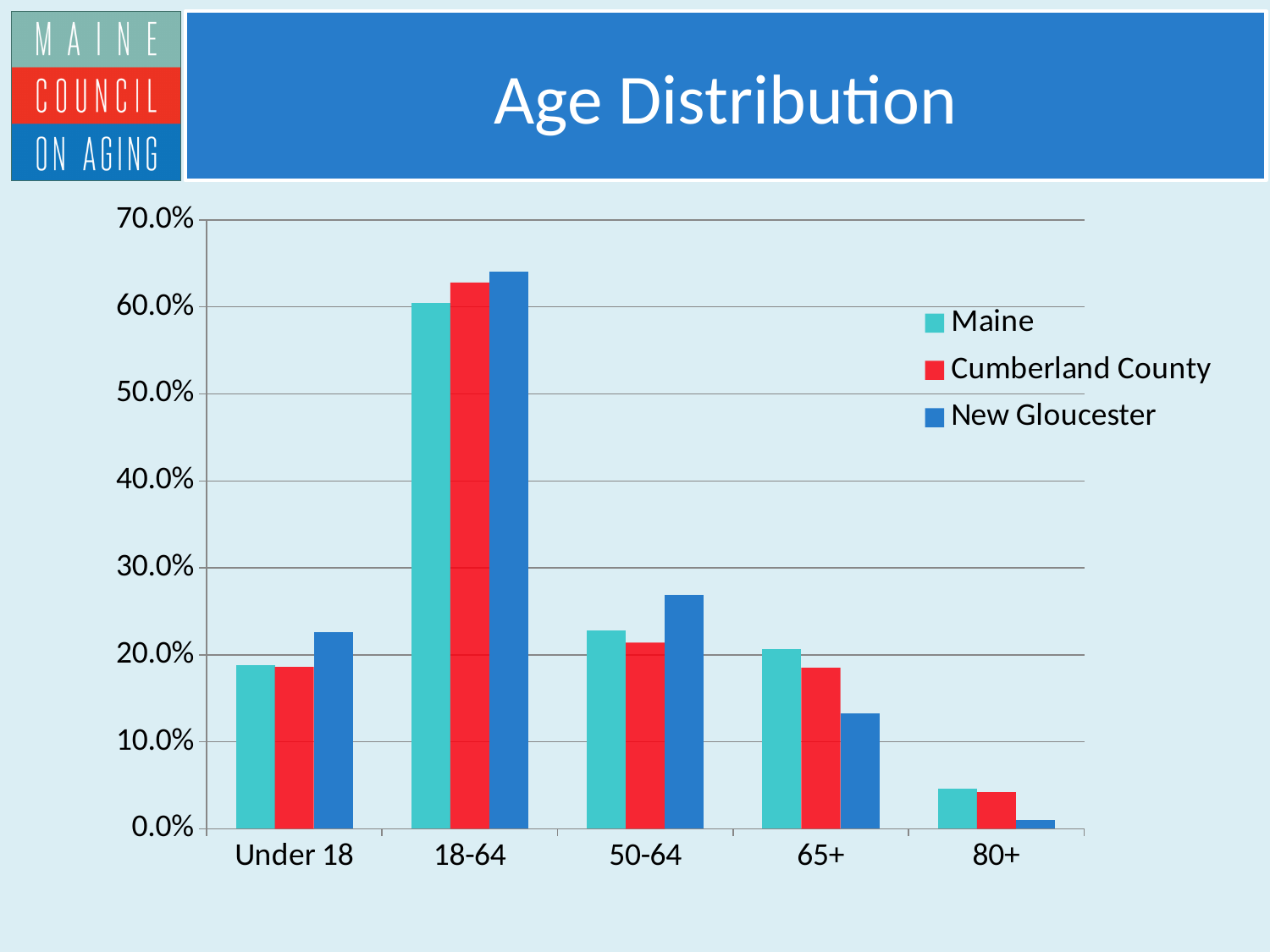
How many series does the legend list? 3 Is the value for Cumberland County in the 65+ group greater or less than 20.0%? less How many age groups are shown on the x axis? 5 Is the value for New Gloucester in the 80+ group greater or less than 10.0%? less In the 65+ group, which is larger: Maine or New Gloucester? Maine What is the title of the slide? Age Distribution What kind of chart is shown on the slide? bar chart Which age group has the lowest value for New Gloucester? 80+ Which age group has the highest value for New Gloucester? 18-64 Is the value for New Gloucester in the 18-64 group greater or less than 60.0%? greater In the 50-64 group, which is larger: New Gloucester or Cumberland County? New Gloucester